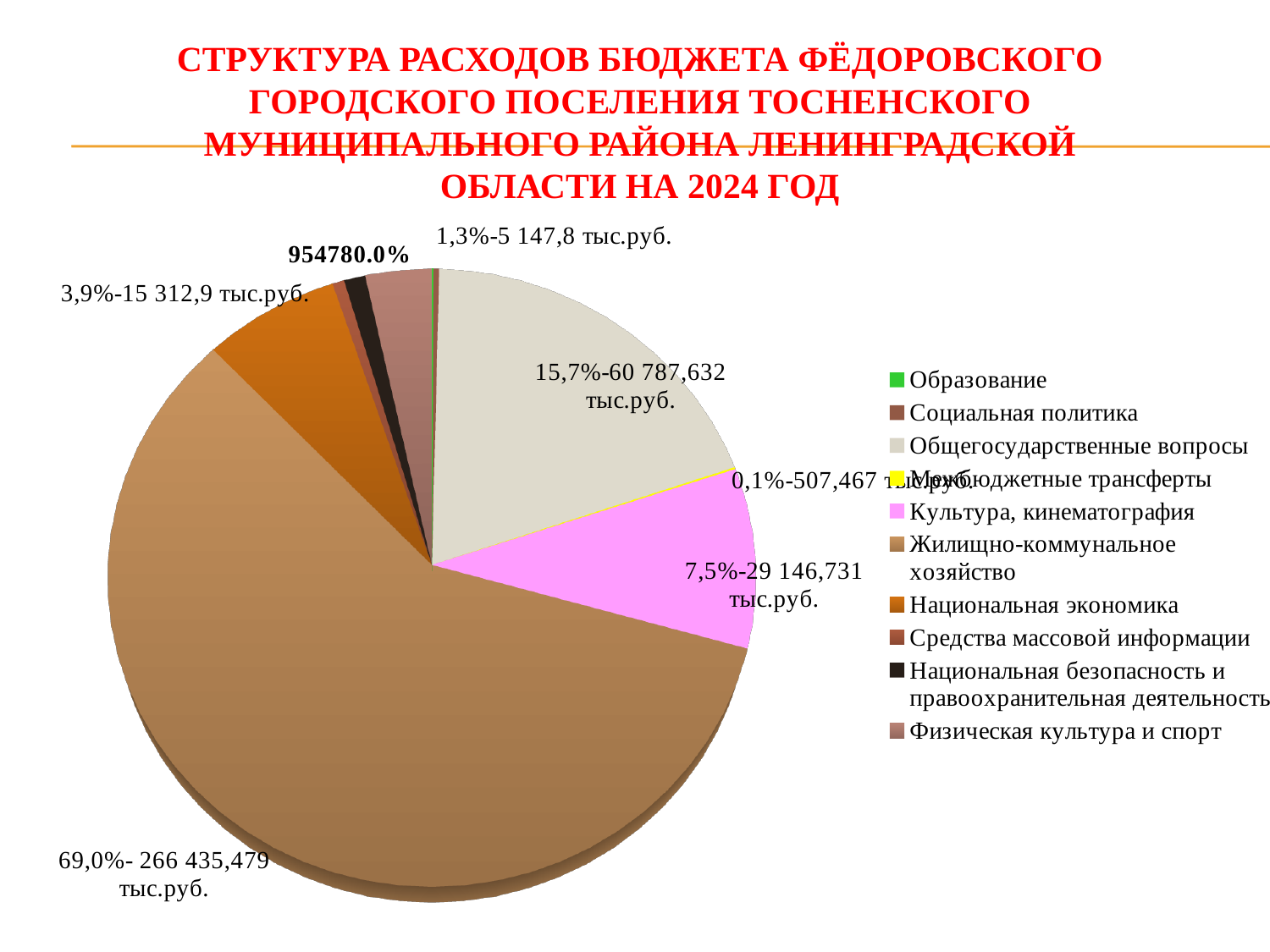
What share of the pie does Национальная экономика have? 3,9% What share of the pie does Жилищно-коммунальное хозяйство have? 69,0% What colour is the slice for Культура, кинематография? pink Which is larger: the share for Общегосударственные вопросы or the share for Культура, кинематография? Общегосударственные вопросы For which year does the chart show the budget expenditure structure? 2024 Which category has the largest share of the pie? Жилищно-коммунальное хозяйство What amount is shown for Культура, кинематография? 29 146,731 тыс.руб. What share of the pie does Общегосударственные вопросы have? 15,7% How many categories does the legend of the pie chart list? 10 What amount is shown for Жилищно-коммунальное хозяйство? 266 435,479 тыс.руб. What kind of chart is shown on the slide? pie chart